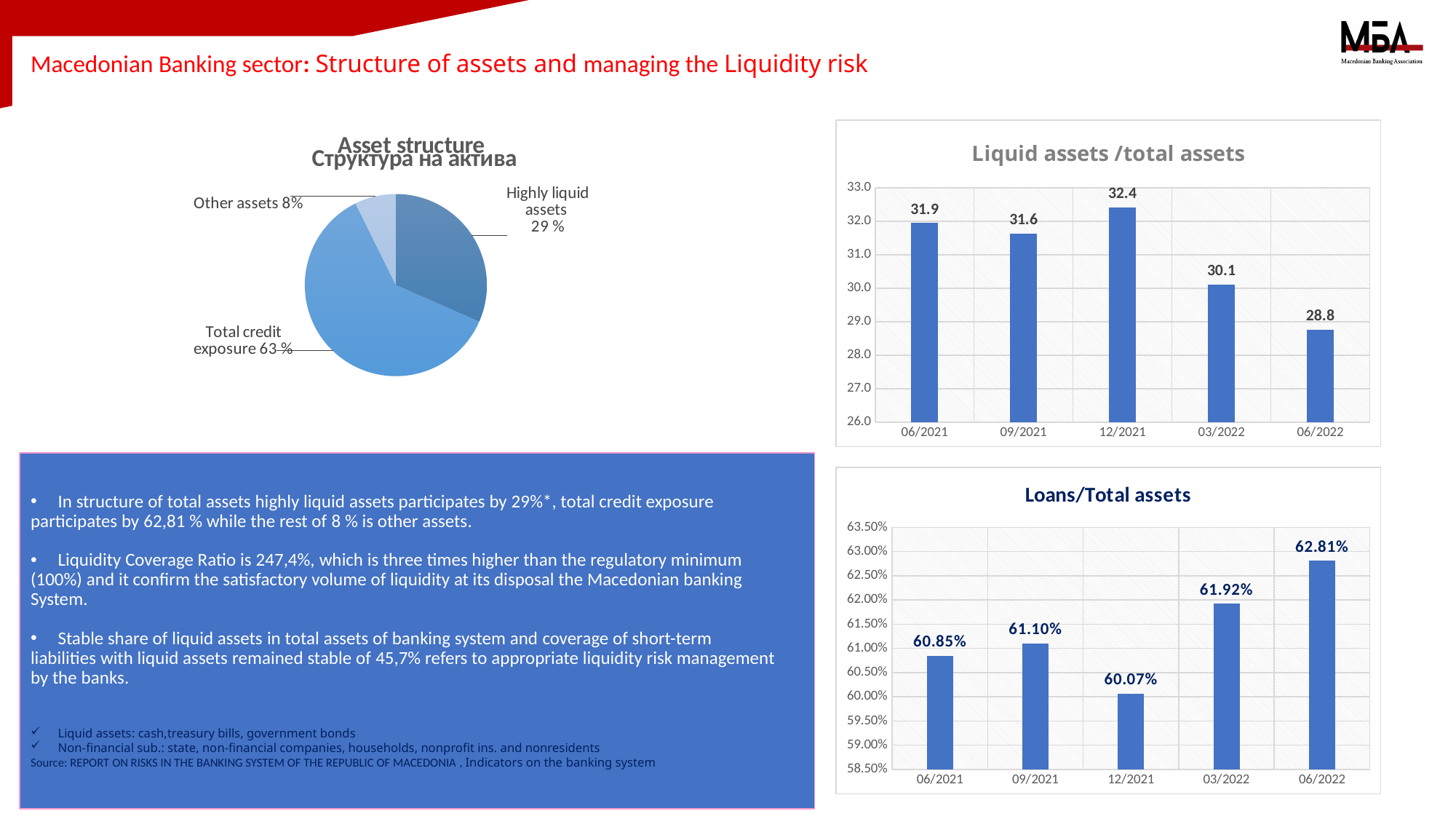
In the 'Loans/Total assets' chart, what is the value for 03/2022? 61.92% In the 'Liquid assets /total assets' chart, which period has the lowest value? 06/2022 In the 'Liquid assets /total assets' chart, what is the difference between the values for 12/2021 and 06/2022? 3.6 In the 'Loans/Total assets' chart, is the value for 06/2022 greater or less than 62.50%? greater In the 'Asset structure' pie chart, what share do Other assets have? 8% In the 'Loans/Total assets' chart, is the value for 09/2021 larger or smaller than the value for 06/2021? larger In the 'Asset structure' pie chart, which slice is the largest? Total credit exposure What kind of chart is the 'Liquid assets /total assets' chart? bar chart In the 'Loans/Total assets' chart, which period has the highest value? 06/2022 In the 'Loans/Total assets' chart, which period has the lowest value? 12/2021 In the 'Liquid assets /total assets' chart, what is the value for 12/2021? 32.4 In the 'Liquid assets /total assets' chart, how many periods are shown on the x axis? 5